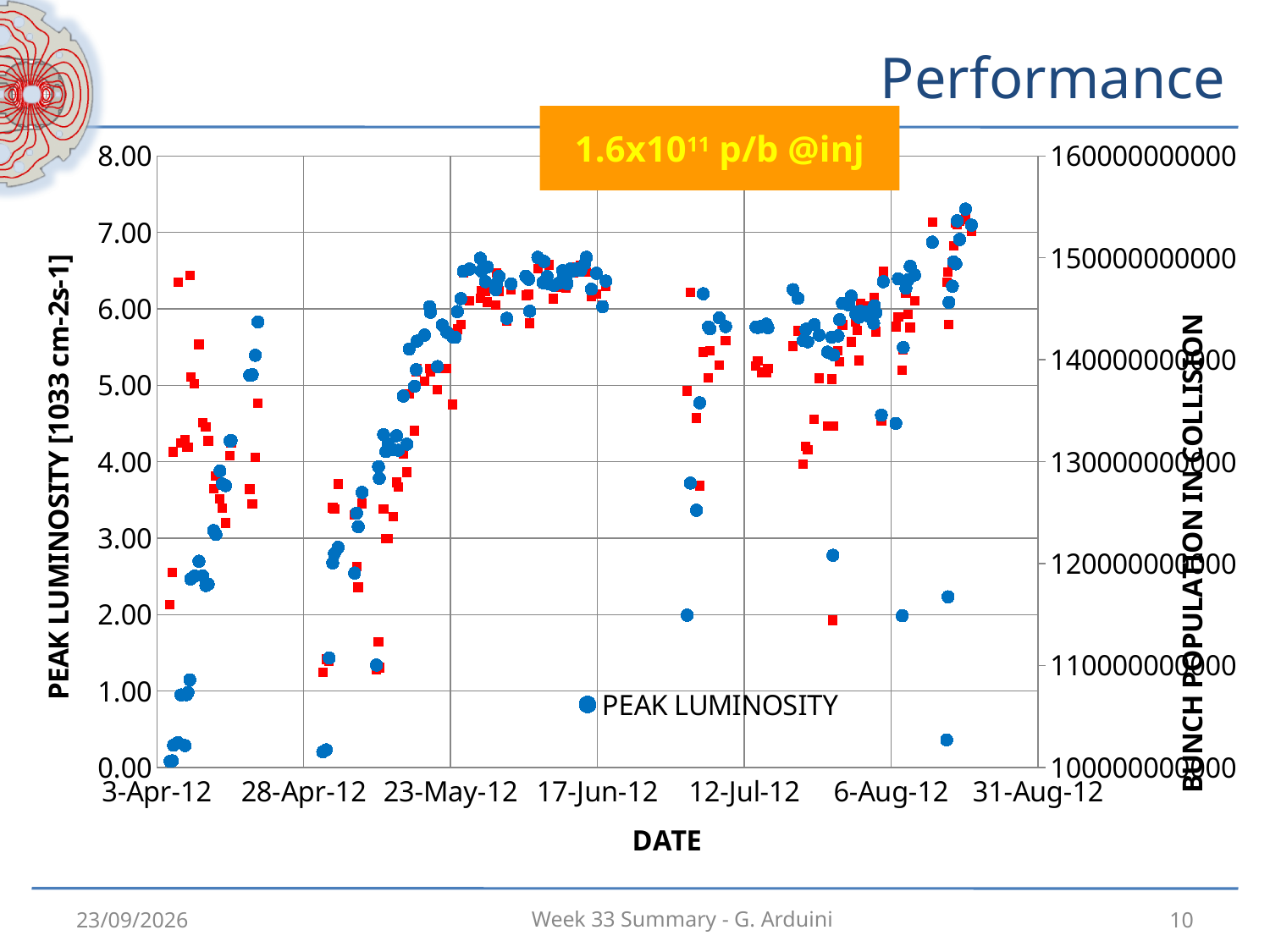
How many series does the chart's legend list? 1 What is the title of the chart's x axis? DATE Is the lowest blue PEAK LUMINOSITY point near 3-Apr-12 greater or less than 1.00? less What series name appears in the chart's legend? PEAK LUMINOSITY What kind of chart is shown on the slide? scatter chart Do the blue PEAK LUMINOSITY points generally rise or fall from 3-Apr-12 to 31-Aug-12? rise Is the highest blue PEAK LUMINOSITY point on the chart greater or less than 7.00? greater